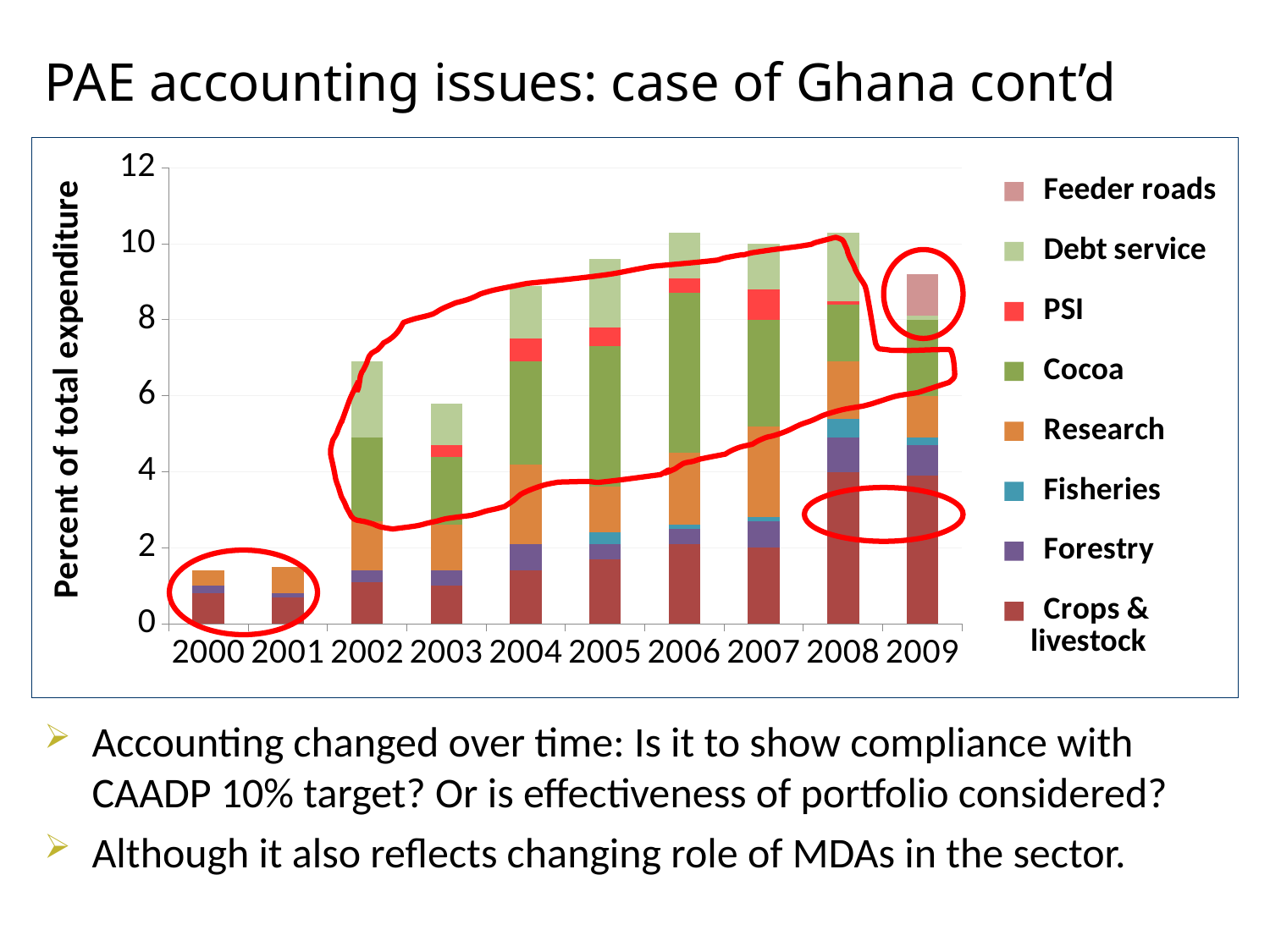
Is the total value of the bar for 2002 greater or less than 6? greater How many years are shown along the x axis of the chart? 10 What kind of chart is shown on the slide? Stacked bar chart Is the total value of the bar for 2006 greater or less than 10? greater Which year has the taller total bar, 2002 or 2003? 2002 What is the label on the vertical axis of the chart? Percent of total expenditure Is the total value of the bar for 2000 greater or less than 2? less Which year has the taller total bar, 2008 or 2009? 2008 How many series does the chart's legend list? 8 Which colour represents Cocoa in the chart? Green